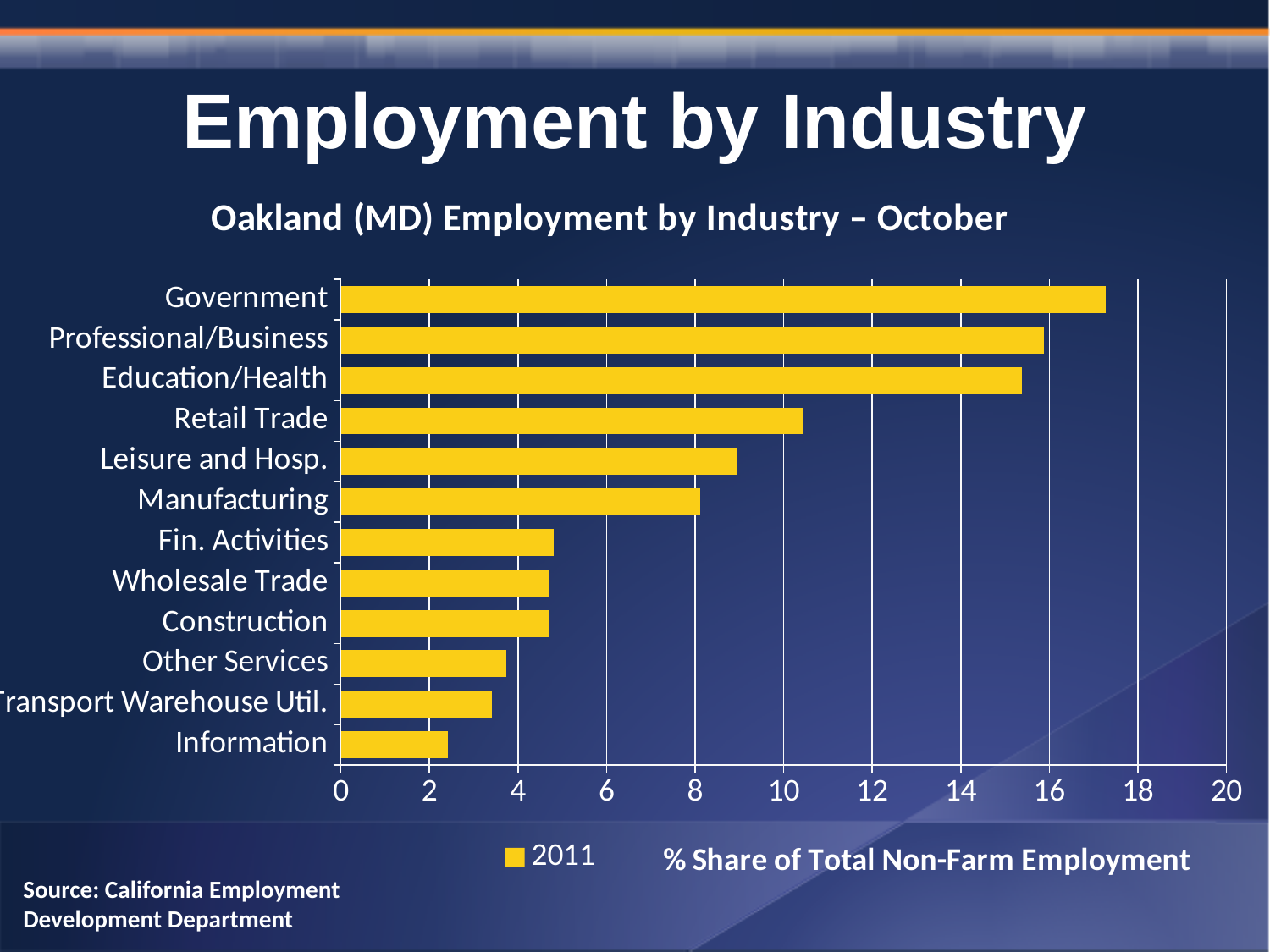
Is the value for Government greater or less than 16? greater What is the title of the chart? Oakland (MD) Employment by Industry – October Which industry has the lowest share of total non-farm employment? Information What year does the legend entry refer to? 2011 Is the value for Information greater or less than 4? less Is the value for Education/Health greater or less than 14? greater What kind of chart is shown on the slide? bar chart How many series does the legend list? 1 How many industries are plotted in the chart? 12 Which has a larger share, Retail Trade or Manufacturing? Retail Trade Which industry has the highest share of total non-farm employment? Government